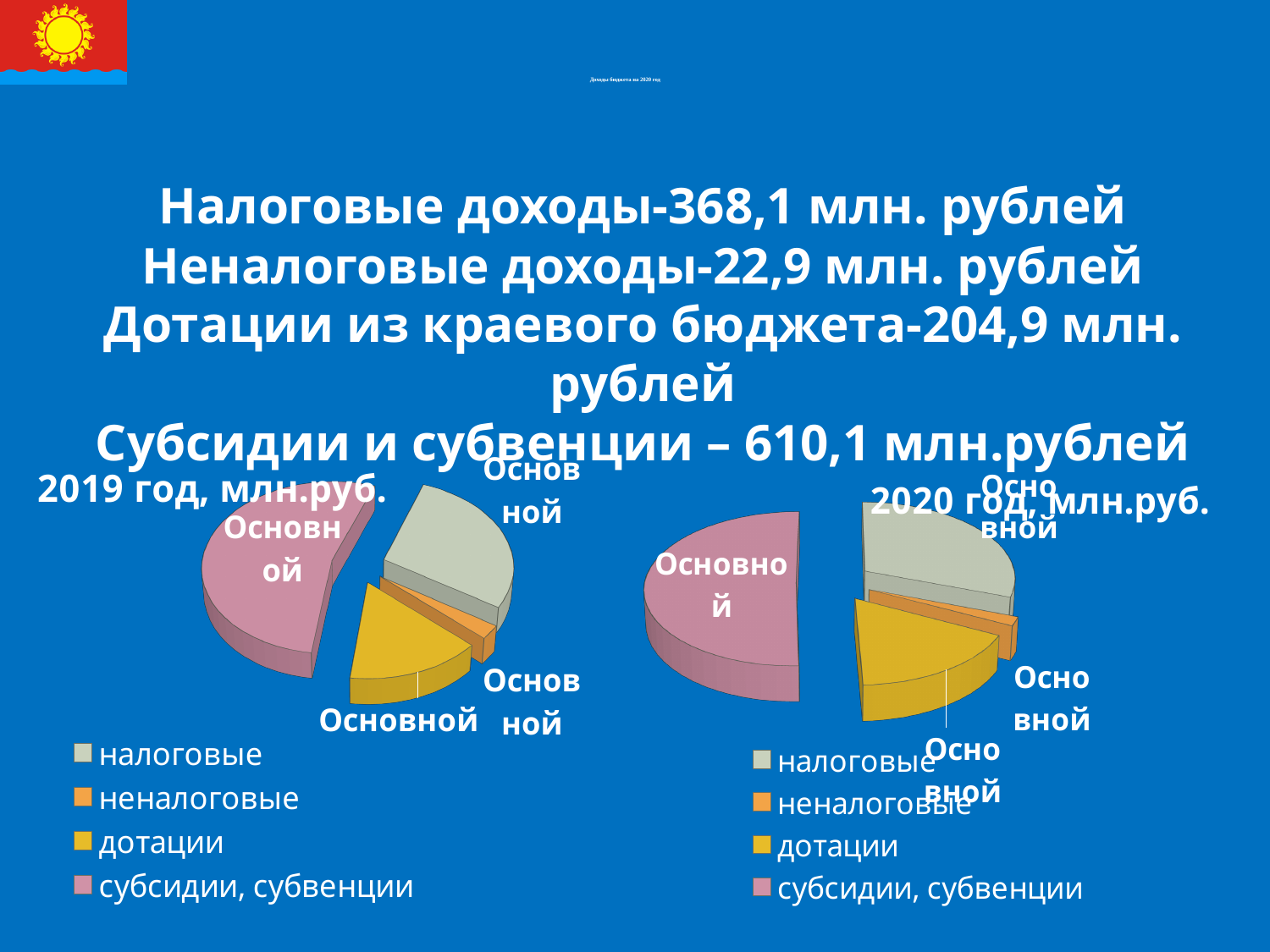
What is the title of the pie chart on the left side of the slide? 2019 год, млн.руб. In the chart titled "2019 год, млн.руб.", which slice is larger: налоговые or неналоговые? налоговые What kind of chart is the chart titled "2020 год, млн.руб."? pie chart In the chart titled "2020 год, млн.руб.", which slice is larger: субсидии, субвенции or дотации? субсидии, субвенции In the chart titled "2020 год, млн.руб.", what colour is the slice for дотации? yellow In the chart titled "2020 год, млн.руб.", which category has the smallest slice? неналоговые What kind of chart is the chart titled "2019 год, млн.руб."? pie chart In the chart titled "2020 год, млн.руб.", how many slices does the pie have? 4 In the chart titled "2019 год, млн.руб.", which category has the largest slice? субсидии, субвенции In the chart titled "2019 год, млн.руб.", how many categories does the legend list? 4 In the chart titled "2020 год, млн.руб.", which category has the largest slice? субсидии, субвенции In the chart titled "2019 год, млн.руб.", which category has the smallest slice? неналоговые